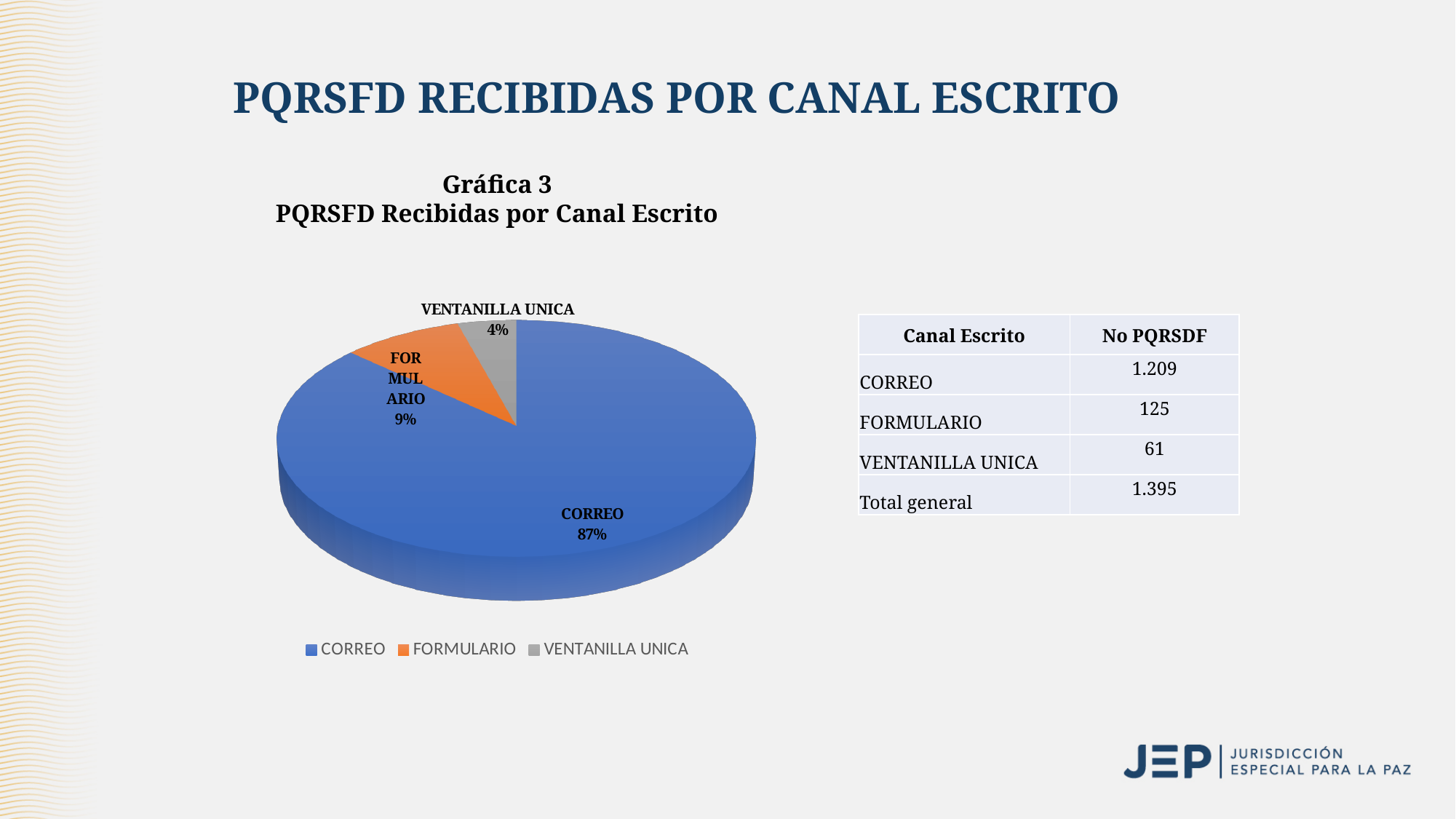
What share of the pie does FORMULARIO represent? 9% What share of the pie does VENTANILLA UNICA represent? 4% What colour is the FORMULARIO slice? Orange What share of the pie does CORREO represent? 87% How many categories are shown in the pie chart? 3 What is the title of the chart? Gráfica 3 PQRSFD Recibidas por Canal Escrito Which category has the largest slice of the pie? CORREO Which slice is larger, FORMULARIO or VENTANILLA UNICA? FORMULARIO What is the difference in percentage points between the CORREO and FORMULARIO slices? 78 How many entries does the legend list? 3 What kind of chart is shown on the slide? Pie chart Which category has the smallest slice of the pie? VENTANILLA UNICA